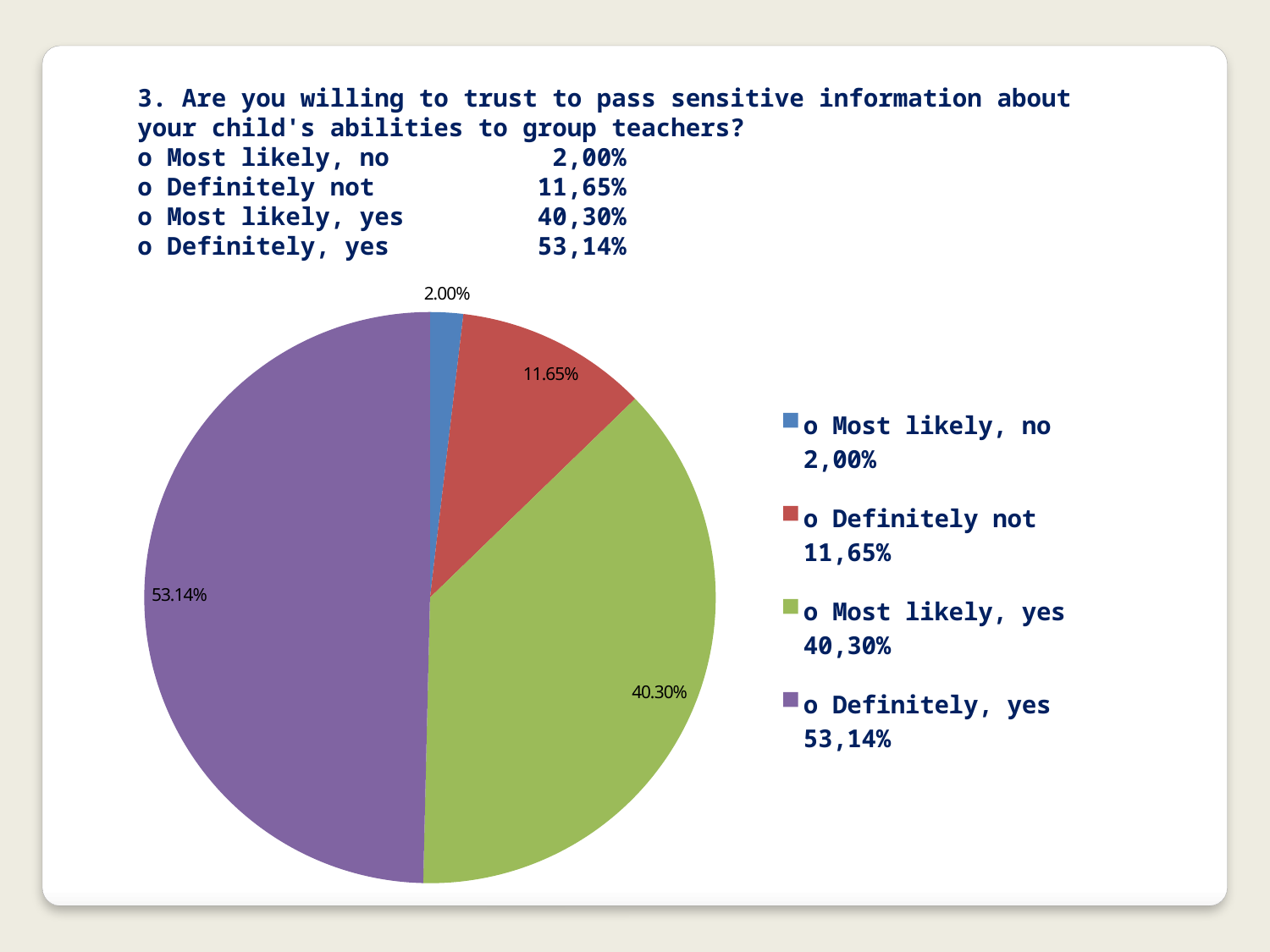
What is the difference between the "Definitely, yes" and "Most likely, yes" values? 12.84% How many slices does the pie chart have? 4 What is the value shown for the "Most likely, no" slice? 2.00% What is the value shown for the "Definitely, yes" slice? 53.14% What is the value shown for the "Most likely, yes" slice? 40.30% What kind of chart is shown on the slide? pie chart Which category has the largest slice of the pie? Definitely, yes How many entries does the legend list? 4 What colour is the "Definitely, yes" slice? purple What is the value shown for the "Definitely not" slice? 11.65% Which is larger, the "Definitely not" slice or the "Most likely, yes" slice? Most likely, yes Which category has the smallest slice of the pie? Most likely, no